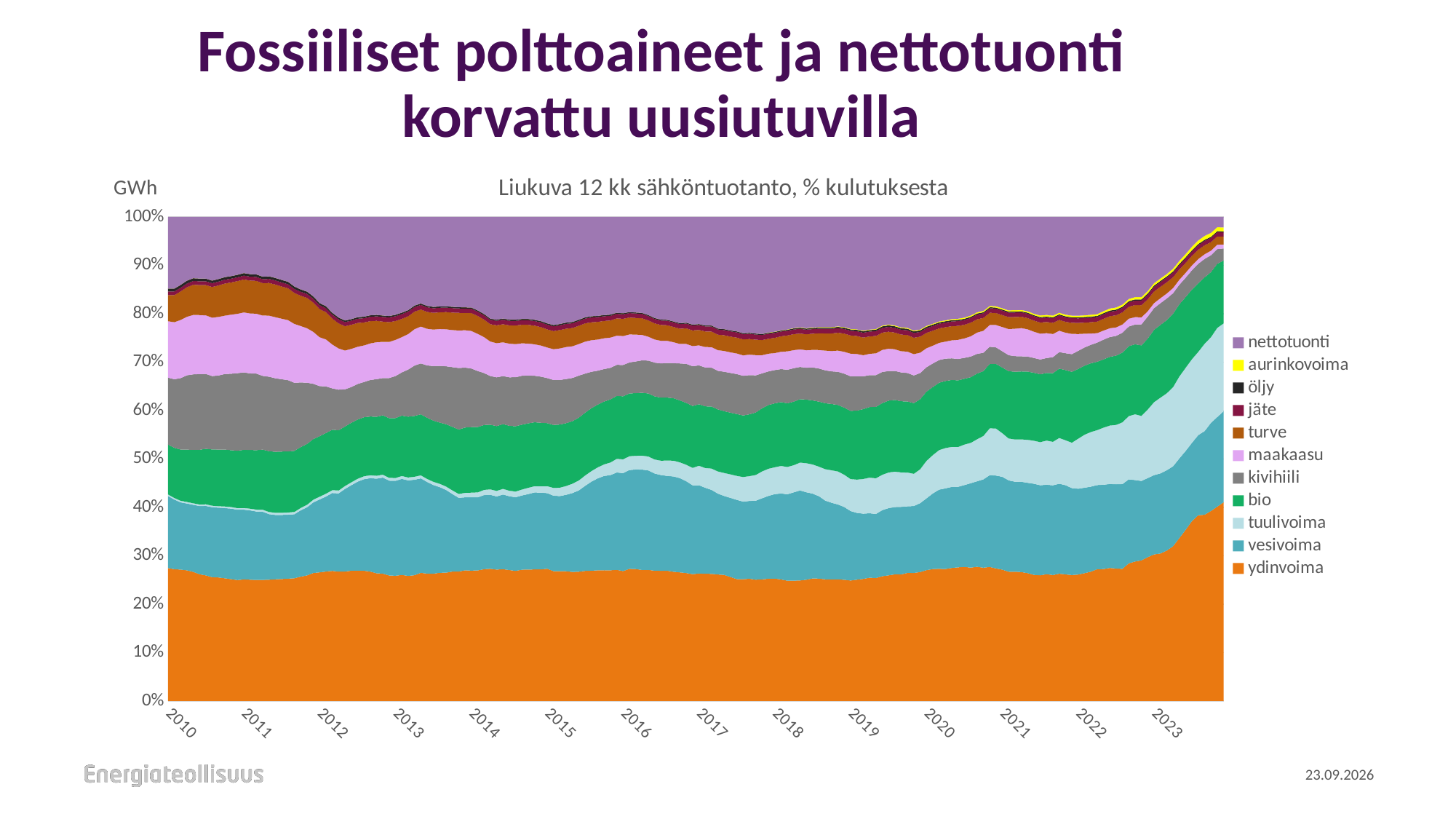
Which series is at the bottom of the stack (the orange area)? ydinvoima Is the share of ydinvoima at the start of 2010 greater or less than 30%? less Which series is at the top of the stack (the purple area)? nettotuonti How many series does the legend list? 11 Does the share of ydinvoima rise or fall from 2010 to the end of 2023? rise How many year labels are shown on the x axis? 14 Does the share of nettotuonti rise or fall from 2010 to the end of 2023? fall Is the share of ydinvoima at the start of 2010 greater or less than 20%? greater What kind of chart is shown on the slide? stacked area chart Is the share of ydinvoima at the end of the series (late 2023) greater or less than 30%? greater In 2010, which band is thicker: vesivoima or bio? vesivoima